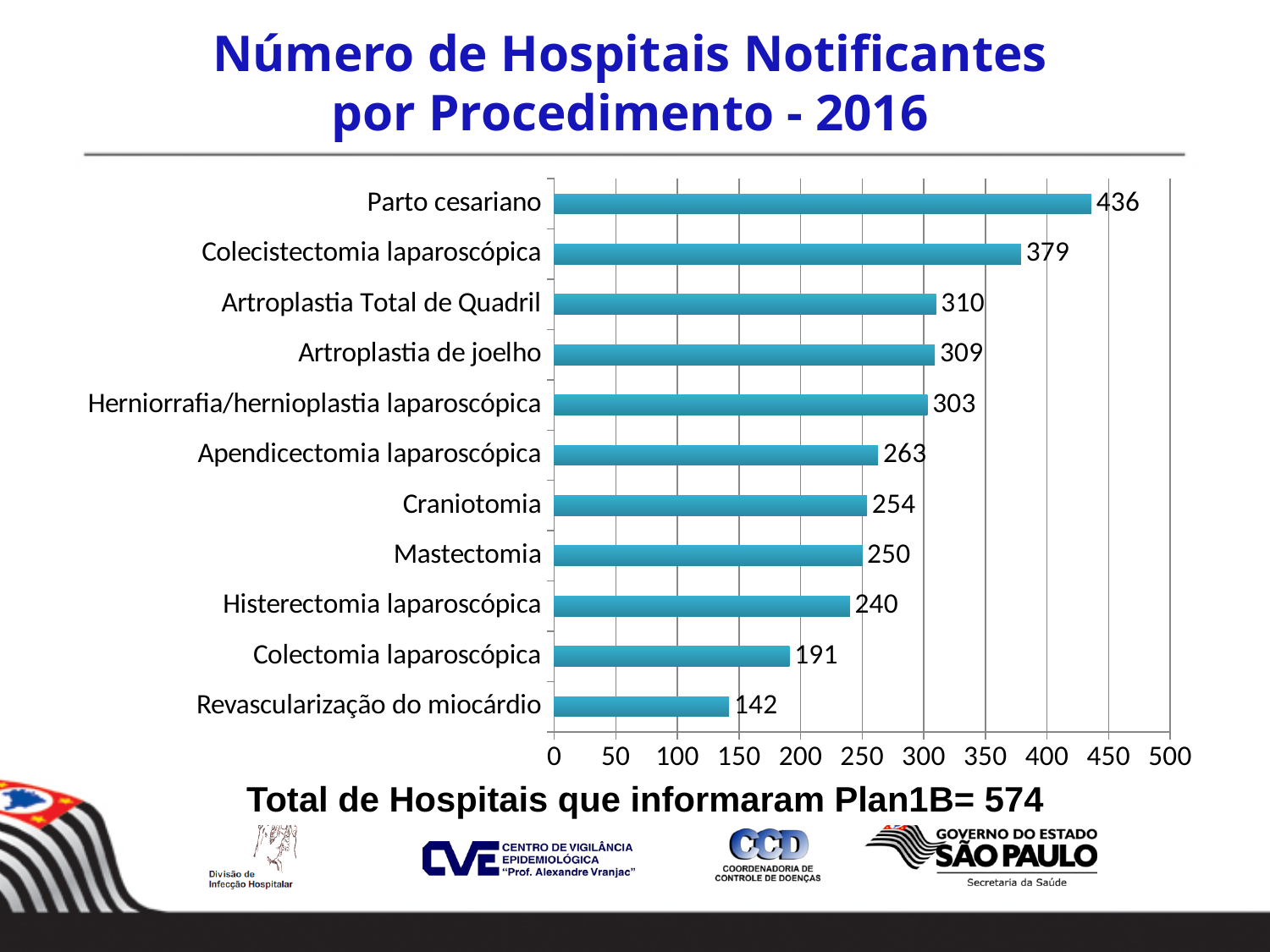
What is the title of the chart? Número de Hospitais Notificantes por Procedimento - 2016 How many hospitals reported Parto cesariano? 436 What is the difference between Parto cesariano and Colecistectomia laparoscópica? 57 What is the value for Craniotomia? 254 What is the difference between Colectomia laparoscópica and Revascularização do miocárdio? 49 What type of chart is shown on the slide? bar chart Which procedure has the highest number of reporting hospitals? Parto cesariano How many procedures are shown in the chart? 11 Which has a larger value, Apendicectomia laparoscópica or Histerectomia laparoscópica? Apendicectomia laparoscópica What is the value for Revascularização do miocárdio? 142 Is the value for Mastectomia greater or less than 300? less Which procedure has the lowest number of reporting hospitals? Revascularização do miocárdio